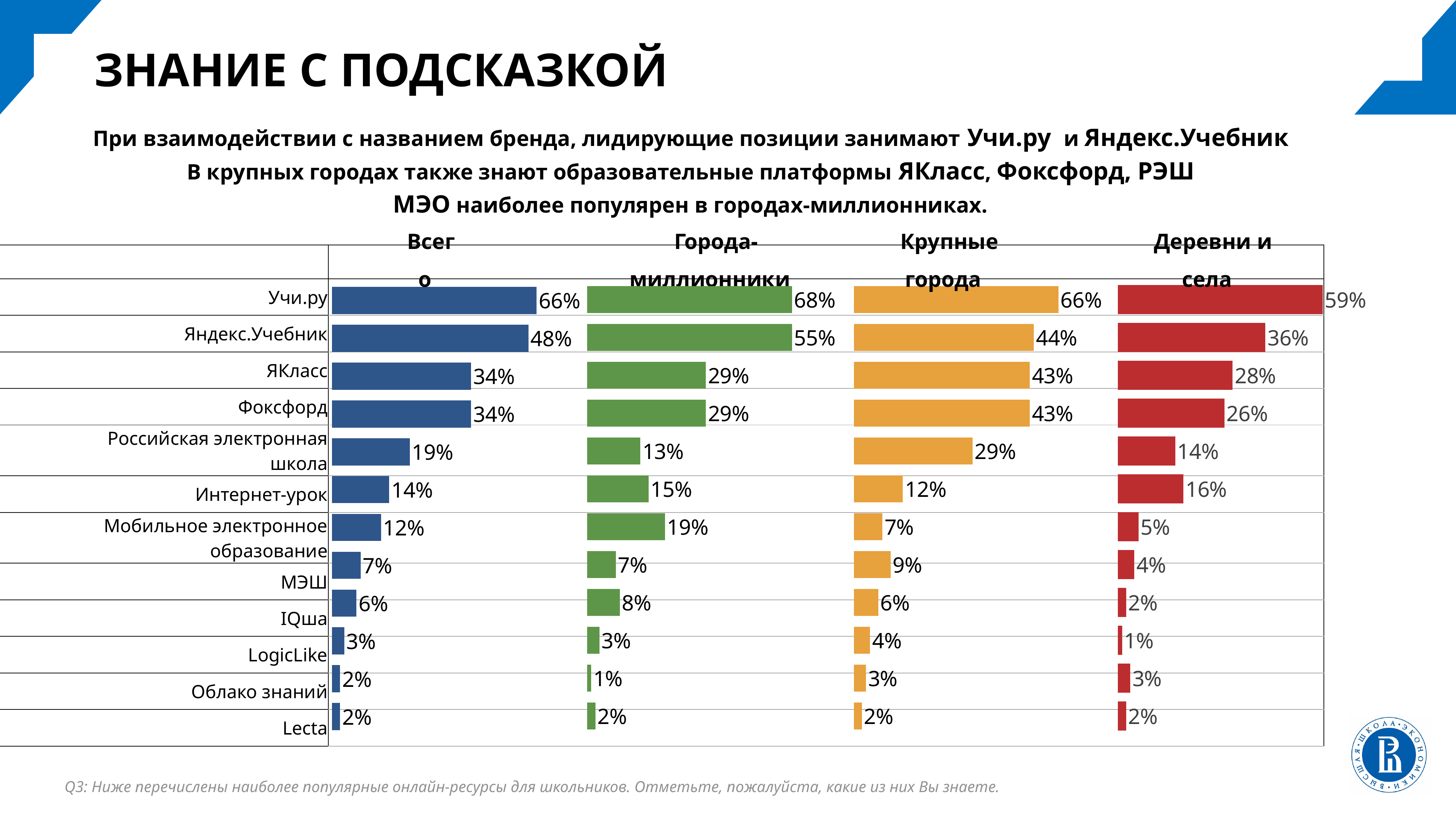
In the "Деревни и села" chart, which category has the lowest value? LogicLike In the "Всего" chart, what is the difference between the values for Учи.ру and Яндекс.Учебник? 18% What type of chart is used for the "Крупные города" data? Bar chart In the "Города-миллионники" chart, which is larger: the value for Мобильное электронное образование or the value for Интернет-урок? Мобильное электронное образование How many categories are shown in the "Всего" chart? 12 In the "Города-миллионники" chart, what is the value for Яндекс.Учебник? 55% In the "Деревни и села" chart, which category has the highest value? Учи.ру In the "Крупные города" chart, what is the difference between the values for ЯКласс and Российская электронная школа? 14% What colour are the bars in the "Города-миллионники" chart? Green In the "Крупные города" chart, what is the value for Российская электронная школа? 29% In the "Деревни и села" chart, what is the value for Интернет-урок? 16% In the "Всего" chart, what is the value for Учи.ру? 66%